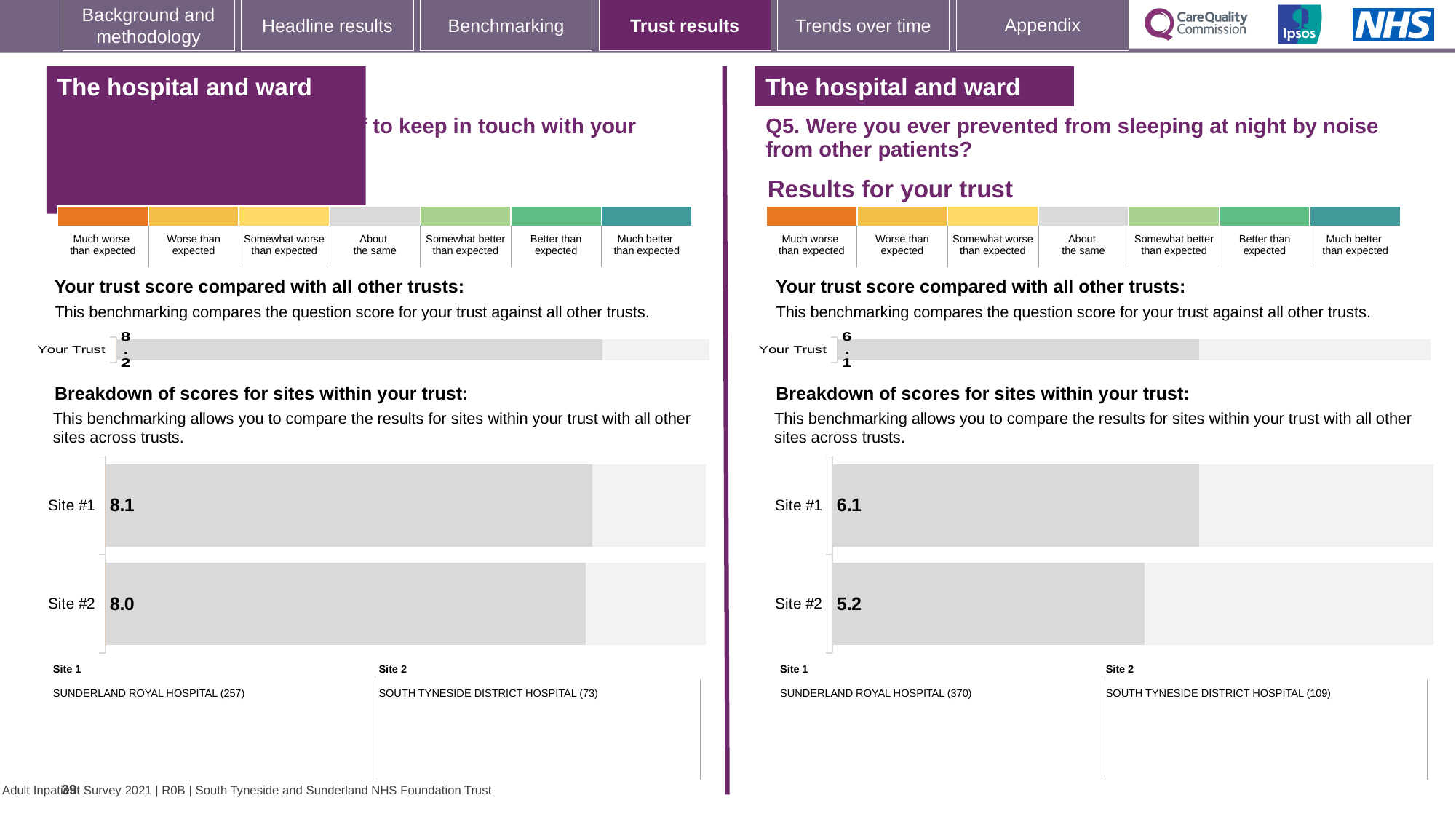
On the left-hand site breakdown chart, what is the score for Site #2? 8.0 On the left-hand chart, what is the difference between the Site #1 and Site #2 scores? 0.1 On the left-hand site breakdown chart, what is the score for Site #1? 8.1 How many sites are shown in the site breakdown chart on the right-hand side (Q5)? 2 On the left-hand chart, what is the score shown for Your Trust? 8.2 On the right-hand chart (Q5), which site has the higher score, Site #1 or Site #2? Site #1 On the right-hand chart (Q5, prevented from sleeping by noise from other patients), what is the score for Site #1? 6.1 On the right-hand side (Q5), which hospital is listed as Site 1? SUNDERLAND ROYAL HOSPITAL (370) On the right-hand chart (Q5), what is the score for Site #2? 5.2 What type of chart is used to show the breakdown of scores for sites on the right-hand side (Q5)? Bar chart On the right-hand chart (Q5), what is the score shown for Your Trust? 6.1 On the right-hand chart (Q5), what is the difference between the Site #1 and Site #2 scores? 0.9